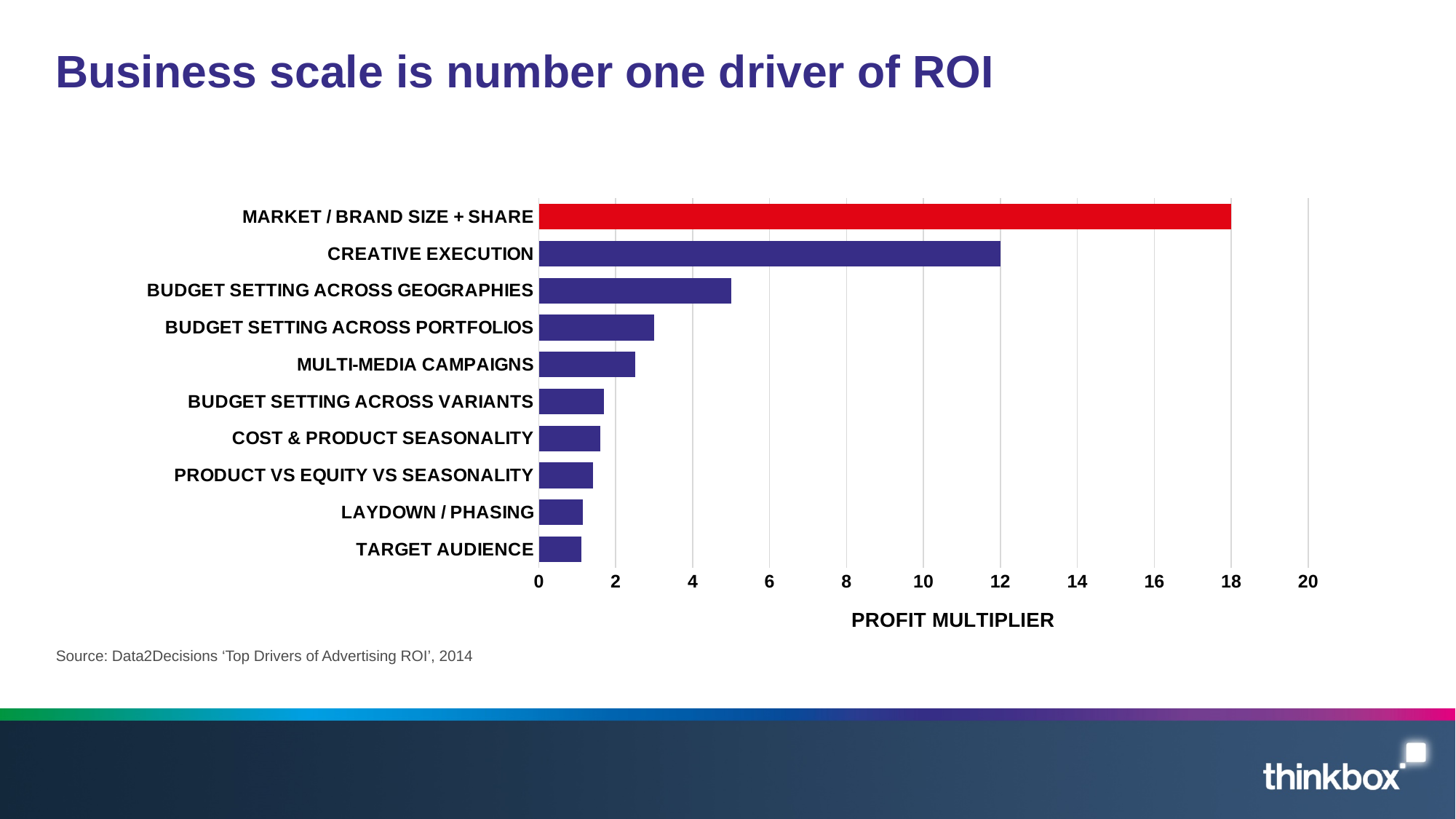
Is the value for Budget Setting Across Geographies greater or less than 4? greater What is the profit multiplier for Market / Brand Size + Share? 18 Which has a larger profit multiplier, Creative Execution or Budget Setting Across Geographies? Creative Execution What is the profit multiplier for Creative Execution? 12 What kind of chart is shown on the slide? Bar chart Is the value for Budget Setting Across Portfolios greater or less than 2? greater Which category has the highest profit multiplier? Market / Brand Size + Share Is the value for Multi-Media Campaigns greater or less than 4? less How many categories are shown in the chart? 10 What is the difference between the profit multipliers for Market / Brand Size + Share and Creative Execution? 6 What is the title of the horizontal axis? PROFIT MULTIPLIER